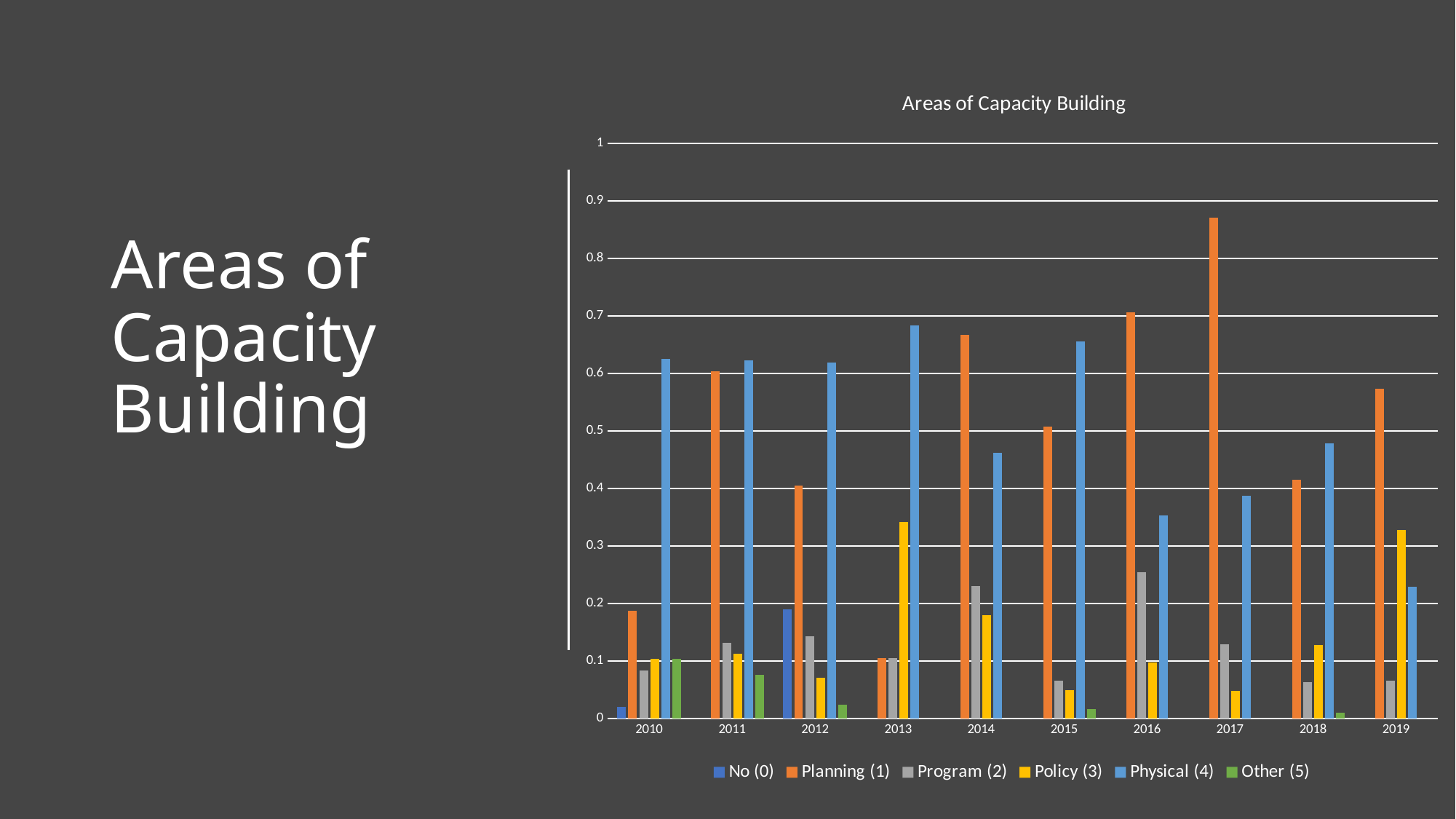
In which year is the Physical (4) bar the highest? 2013 In 2014, which is larger: Planning (1) or Physical (4)? Planning (1) Which series has the lowest value in 2010? No (0) What is the title of the chart? Areas of Capacity Building What kind of chart is shown on the slide? bar chart How many series does the legend list? 6 Is the value for Physical (4) in 2019 greater or less than 0.3? less How many years are shown on the x axis? 10 Is the value for Planning (1) in 2017 greater or less than 0.8? greater In 2013, which is larger: Physical (4) or Policy (3)? Physical (4) In which year is the Planning (1) bar the highest? 2017 Is the value for Policy (3) in 2013 greater or less than 0.3? greater